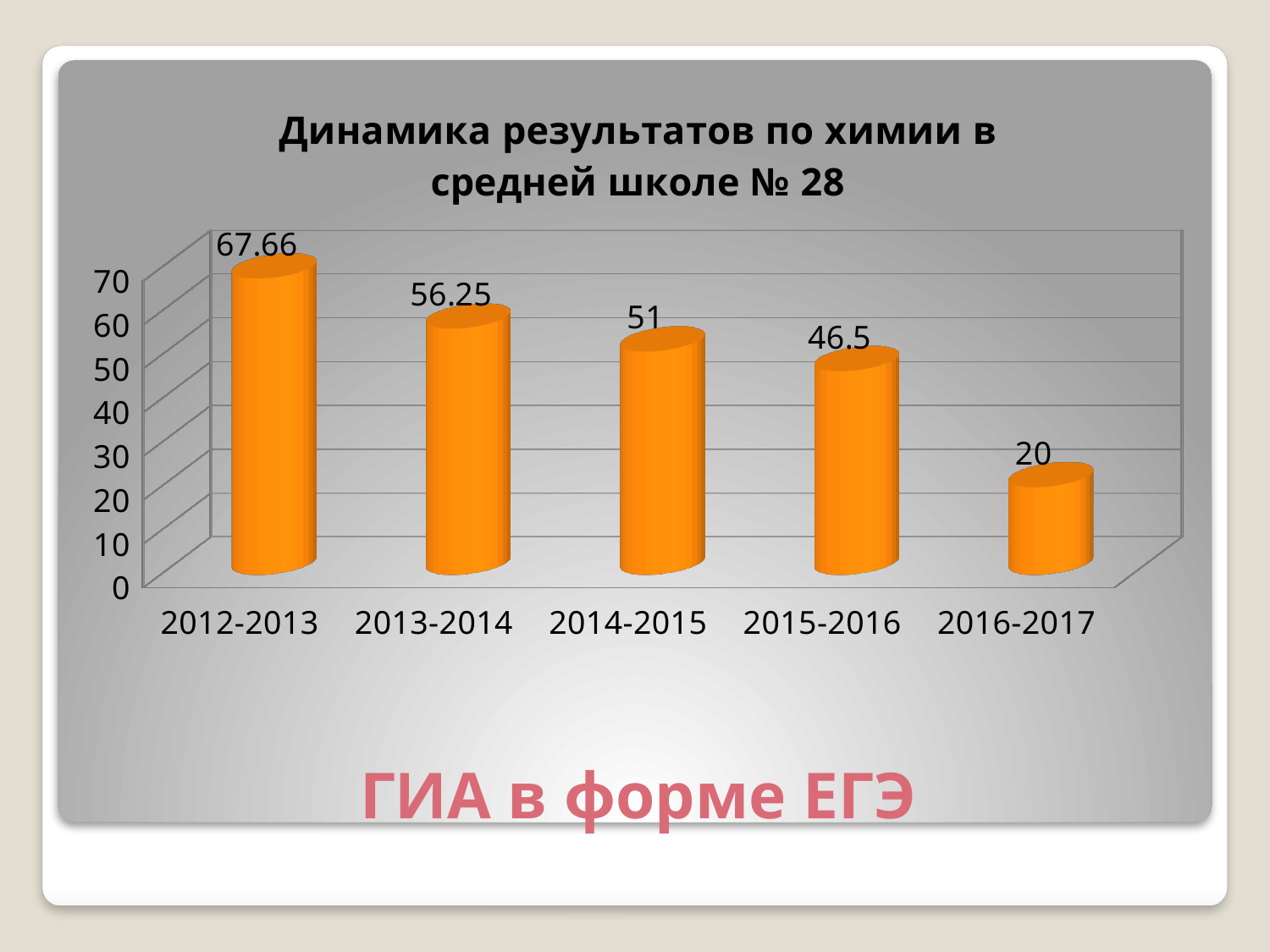
What kind of chart is shown on the slide? bar chart Is the value for 2015-2016 greater or less than 50? less What is the value for 2014-2015? 51 Which year has the highest value? 2012-2013 Which year has the lowest value? 2016-2017 Which is larger, the value for 2013-2014 or the value for 2015-2016? 2013-2014 What is the value for 2012-2013? 67.66 Do the values rise or fall from 2012-2013 to 2016-2017? fall What is the difference between the values for 2012-2013 and 2013-2014? 11.41 What is the difference between the values for 2015-2016 and 2016-2017? 26.5 How many years are shown on the x axis? 5 What is the value for 2016-2017? 20